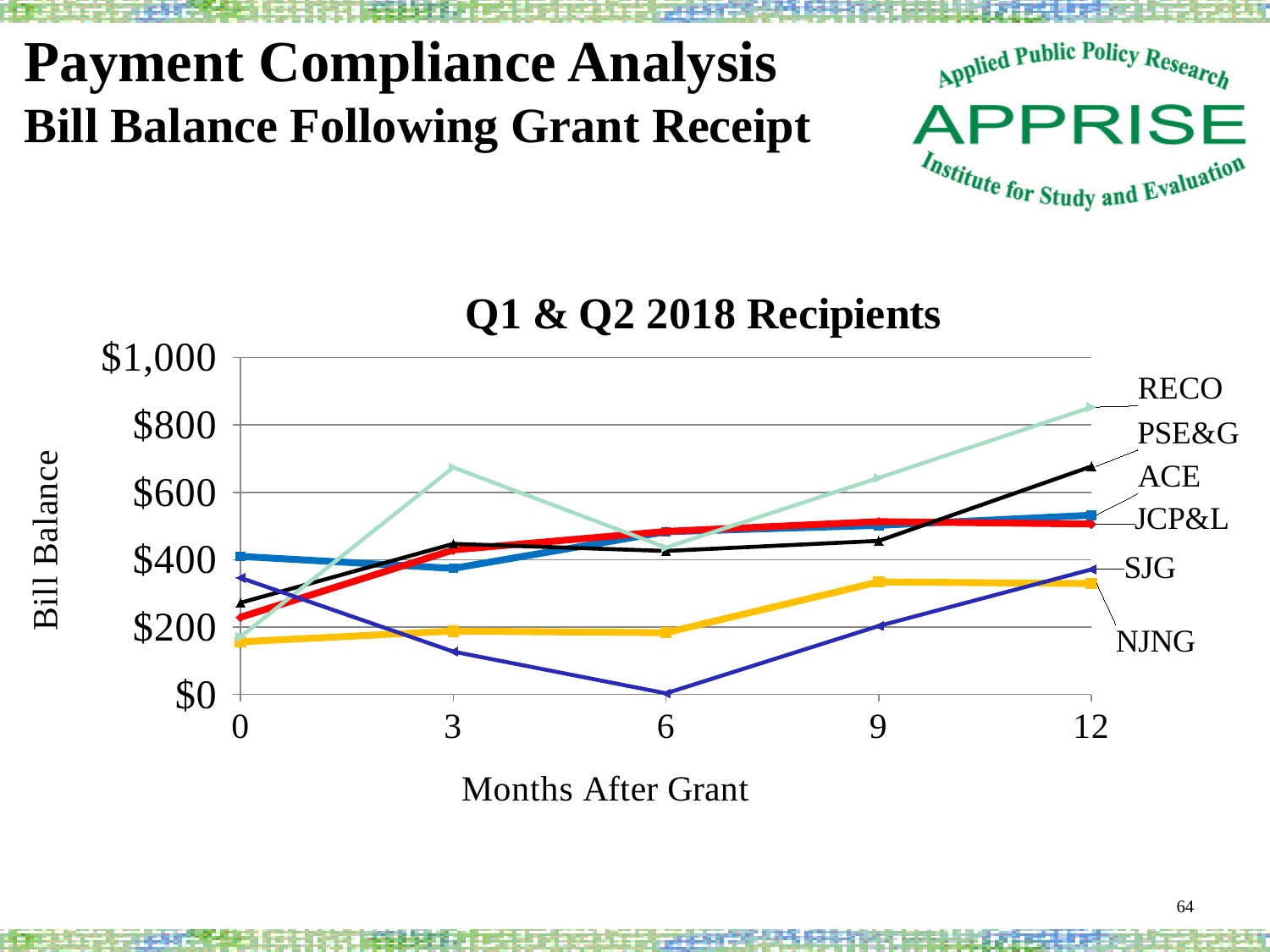
What is the title of the chart? Q1 & Q2 2018 Recipients At 3 months after grant, which has the larger bill balance, RECO or NJNG? RECO Does the bill balance for SJG rise or fall between 0 and 6 months after grant? fall Is the bill balance for PSE&G at 12 months greater or less than $600? greater Is the bill balance for RECO at 12 months greater or less than $800? greater Which utility has the highest bill balance at 12 months after grant? RECO Is the bill balance for SJG at 6 months greater or less than $200? less How many points are marked on the Months After Grant axis? 5 What is the title of the horizontal axis? Months After Grant How many series (utilities) are labelled on the chart? 6 Which utility has the lowest bill balance at 6 months after grant? SJG What kind of chart is shown on the slide? line chart